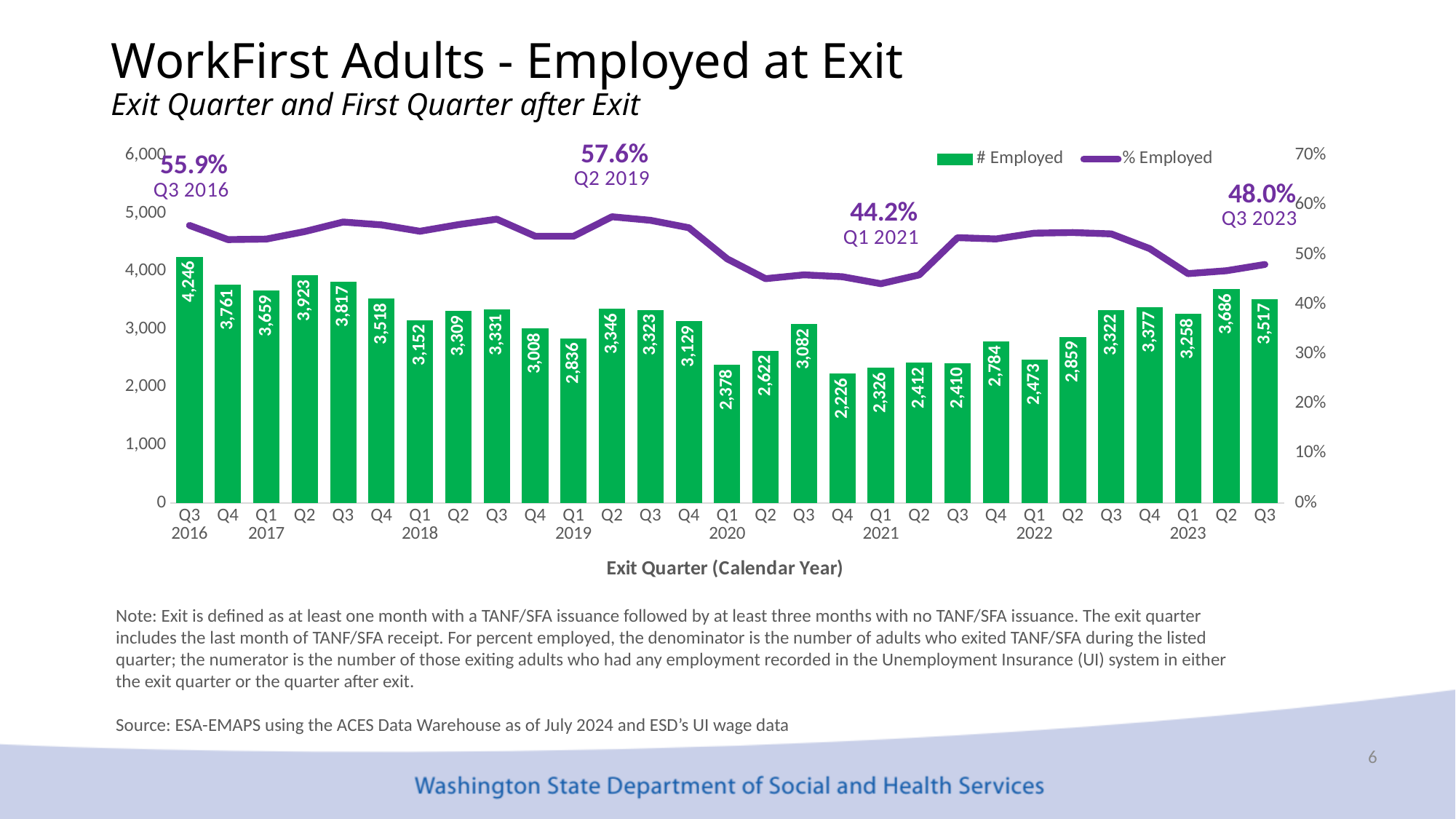
Which exit quarter has the highest number employed? Q3 2016 What is the difference in number employed between Q2 2023 and Q3 2023? 169 Which exit quarter has the lowest number employed? Q4 2020 How many exit quarters are plotted on the chart? 29 What is the number employed for Q3 2016? 4,246 What type of chart is shown on the slide? Combined bar and line chart Is the percent employed for Q4 2020 greater or less than 50%? less Which has a larger number employed, Q3 2022 or Q1 2023? Q3 2022 How many series does the legend list? 2 What is the number employed for Q4 2020? 2,226 What is the percent employed labeled for Q2 2019? 57.6% What is the percent employed labeled for Q1 2021? 44.2%